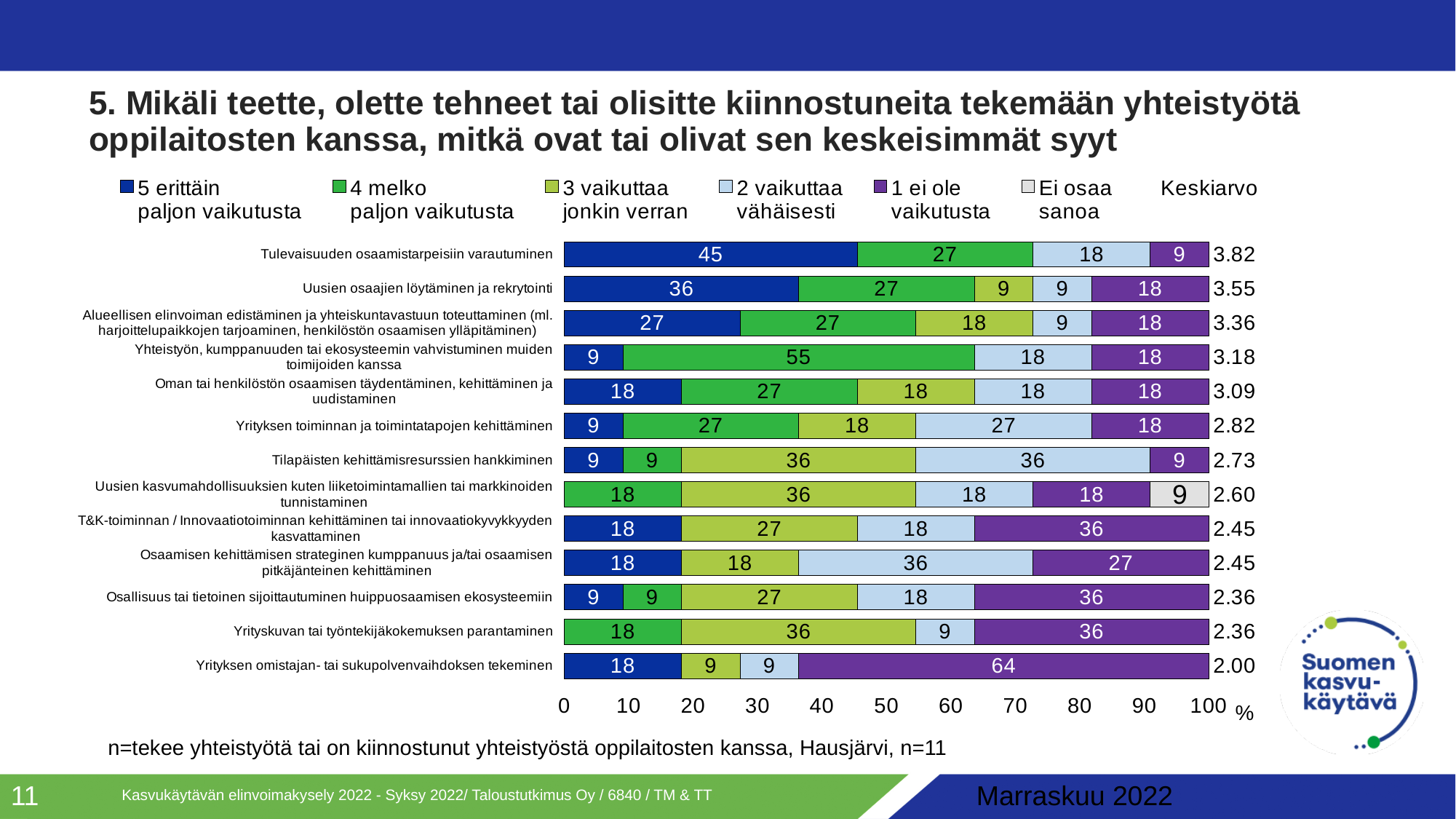
What type of chart is shown on the slide? Stacked bar chart How many categories (bars) are shown in the chart? 13 Which legend entry is represented by the dark blue colour? 5 erittäin paljon vaikutusta Which category has the lowest Keskiarvo value? Yrityksen omistajan- tai sukupolvenvaihdoksen tekeminen What is the '3 vaikuttaa jonkin verran' value for 'Tilapäisten kehittämisresurssien hankkiminen'? 36 Which has a larger '5 erittäin paljon vaikutusta' share: 'Tulevaisuuden osaamistarpeisiin varautuminen' or 'Uusien osaajien löytäminen ja rekrytointi'? Tulevaisuuden osaamistarpeisiin varautuminen What is the Keskiarvo value shown for 'Tulevaisuuden osaamistarpeisiin varautuminen'? 3.82 What is the '4 melko paljon vaikutusta' value for 'Yhteistyön, kumppanuuden tai ekosysteemin vahvistuminen muiden toimijoiden kanssa'? 55 What is the difference between the Keskiarvo of 'Tulevaisuuden osaamistarpeisiin varautuminen' and that of 'Yrityksen omistajan- tai sukupolvenvaihdoksen tekeminen'? 1.82 Which category has the highest Keskiarvo value? Tulevaisuuden osaamistarpeisiin varautuminen What is the '1 ei ole vaikutusta' value for 'Yrityksen omistajan- tai sukupolvenvaihdoksen tekeminen'? 64 What percentage of respondents chose '5 erittäin paljon vaikutusta' for 'Uusien osaajien löytäminen ja rekrytointi'? 36